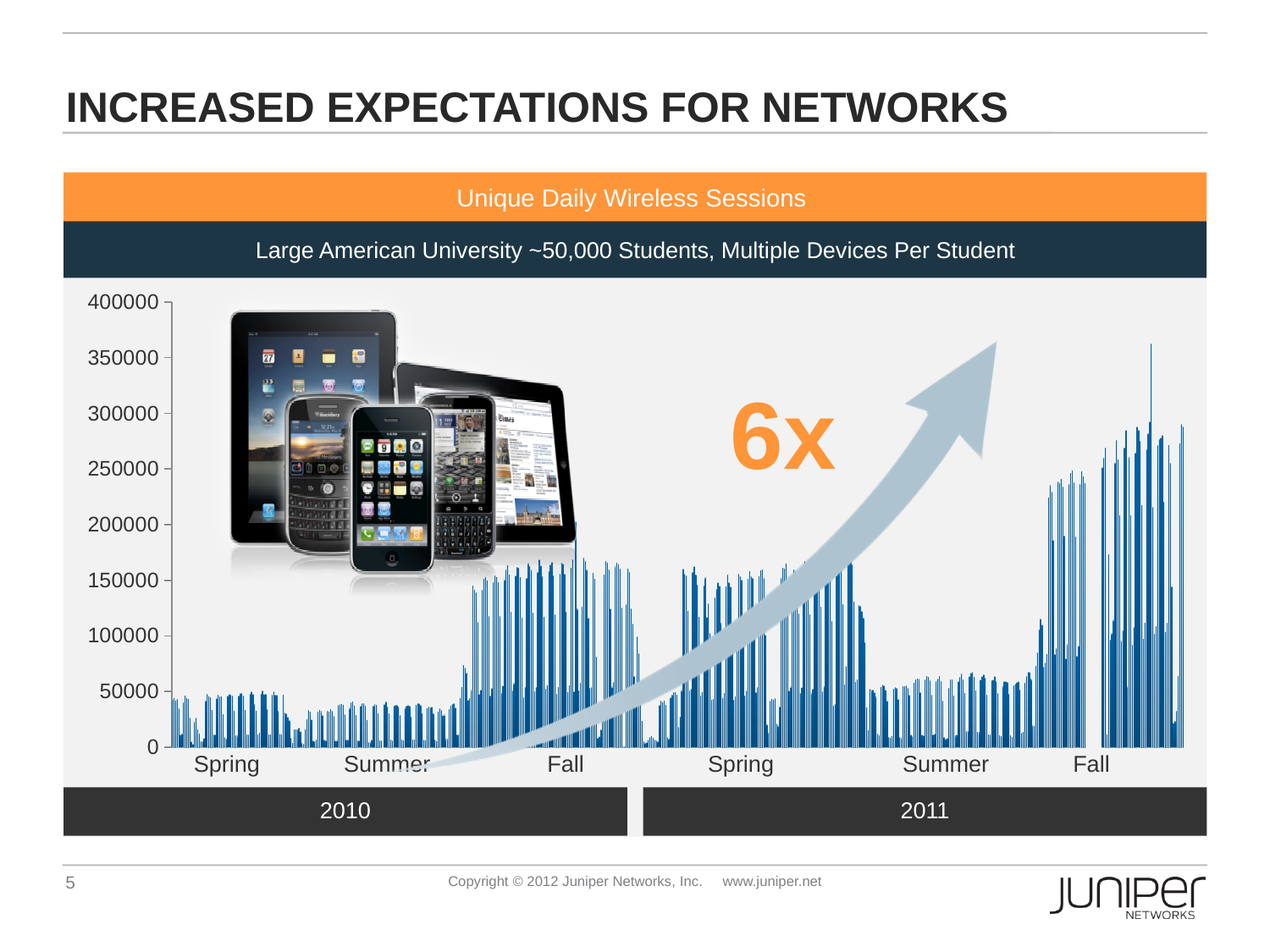
What multiplier is highlighted in orange on the chart? 6x Are the values in Spring 2010 greater or less than 100000? less How many years are labeled along the x axis? 2 Which season in which year shows the lowest daily wireless sessions? Summer 2010 Which season in which year shows the highest daily wireless sessions? Fall 2011 Are the peak values in Spring 2011 greater or less than 200000? less What is the title of the chart? Unique Daily Wireless Sessions Are the values in Summer 2011 greater or less than 100000? less Which has higher daily wireless sessions, Fall 2010 or Fall 2011? Fall 2011 Overall, do the daily wireless sessions rise or fall from Spring 2010 to Fall 2011? rise What kind of chart is shown on the slide? bar chart